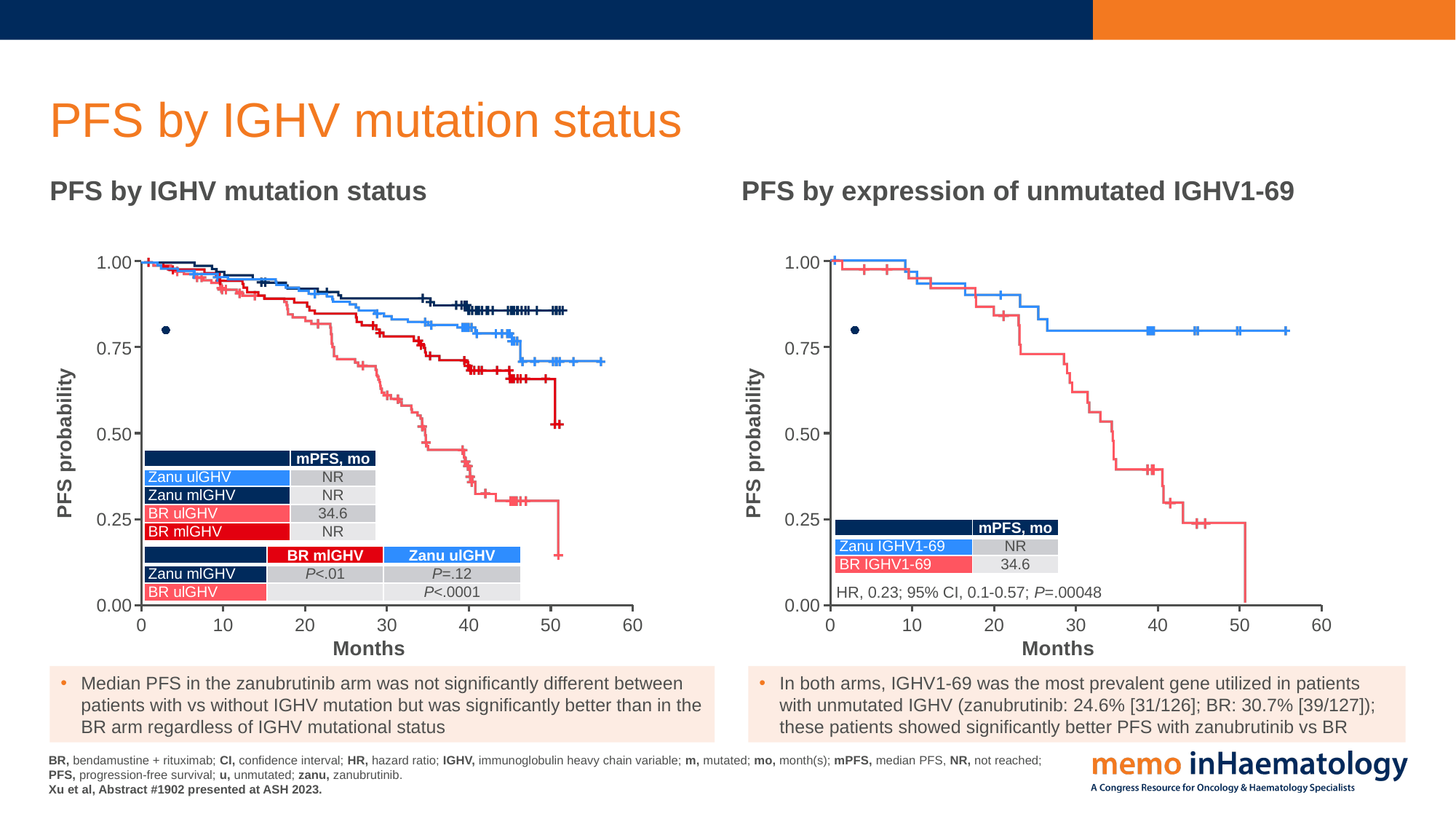
How many patient groups (curves) are plotted in the left chart (PFS by IGHV mutation status)? 4 In the right chart (PFS by expression of unmutated IGHV1-69), does the PFS probability rise or fall as months increase? fall In the right chart (PFS by expression of unmutated IGHV1-69), what is the hazard ratio shown? 0.23 How many patient groups (curves) are plotted in the right chart (PFS by expression of unmutated IGHV1-69)? 2 In the left chart (PFS by IGHV mutation status), what is the median PFS for Zanu uIGHV? NR In the left chart (PFS by IGHV mutation status), what is the median PFS in months for BR uIGHV? 34.6 In the right chart (PFS by expression of unmutated IGHV1-69), what is the median PFS in months for BR IGHV1-69? 34.6 In the left chart (PFS by IGHV mutation status), what is the P value for Zanu mIGHV vs Zanu uIGHV? P=.12 In the left chart (PFS by IGHV mutation status), what is the P value for Zanu mIGHV vs BR mIGHV? P<.01 In the left chart (PFS by IGHV mutation status), what is the P value for BR uIGHV vs Zanu uIGHV? P<.0001 In the left chart (PFS by IGHV mutation status), which group has the lowest PFS probability at 50 months? BR uIGHV In the right chart (PFS by expression of unmutated IGHV1-69), is the PFS probability for BR IGHV1-69 at 40 months greater or less than 0.50? less